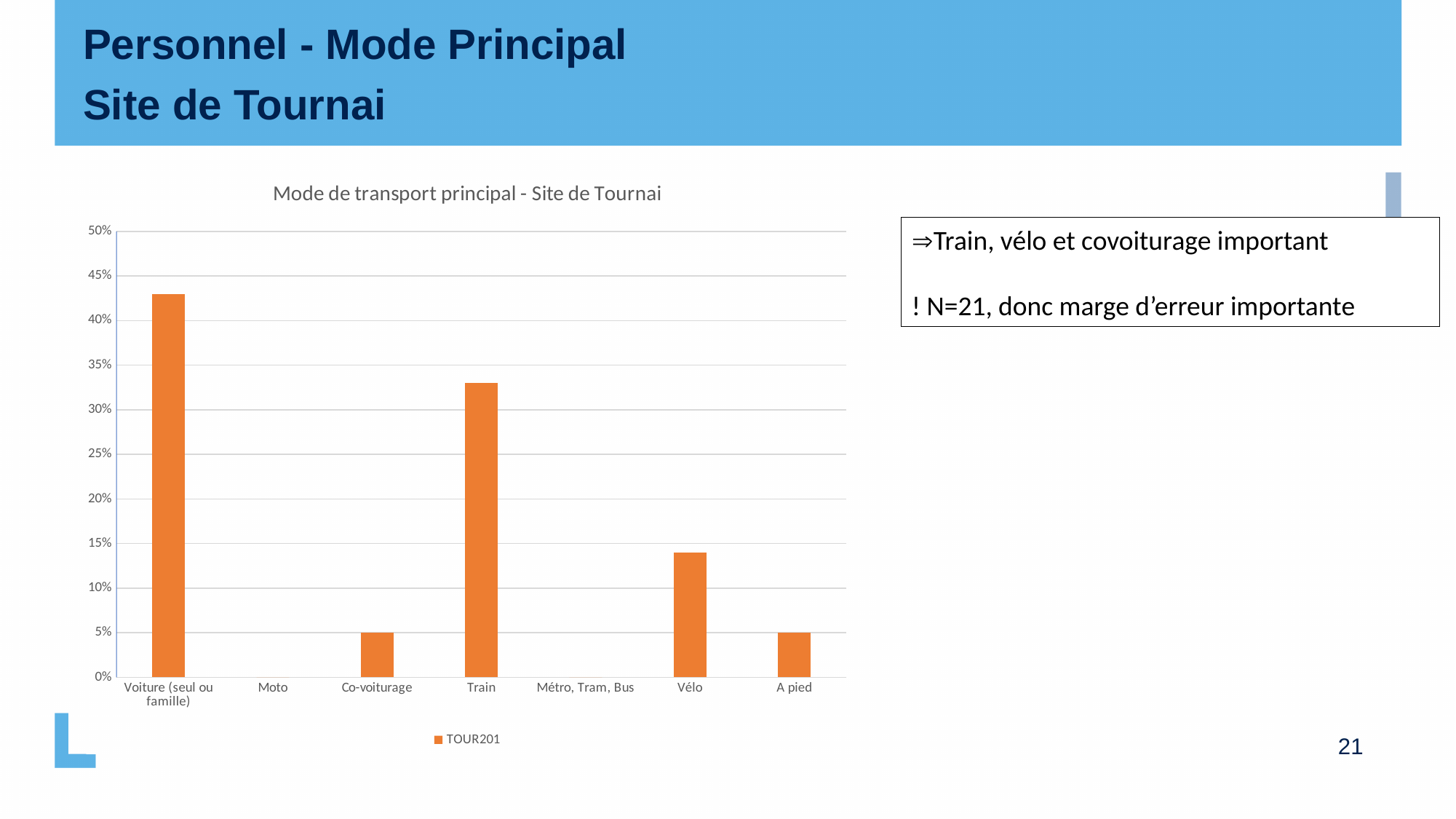
How many categories are shown on the x axis of the chart? 7 What kind of chart is shown on the slide? bar chart Which is larger, the value for Train or the value for Vélo? Train Is the value for Train greater or less than 30%? greater Is the value for Vélo greater or less than 10%? greater Which category has the highest value in the chart? Voiture (seul ou famille) What is the value for Co-voiturage? 5% Is the value for Voiture (seul ou famille) greater or less than 40%? greater What is the name of the series shown in the legend? TOUR201 How many series does the chart legend list? 1 What is the title of the chart? Mode de transport principal - Site de Tournai